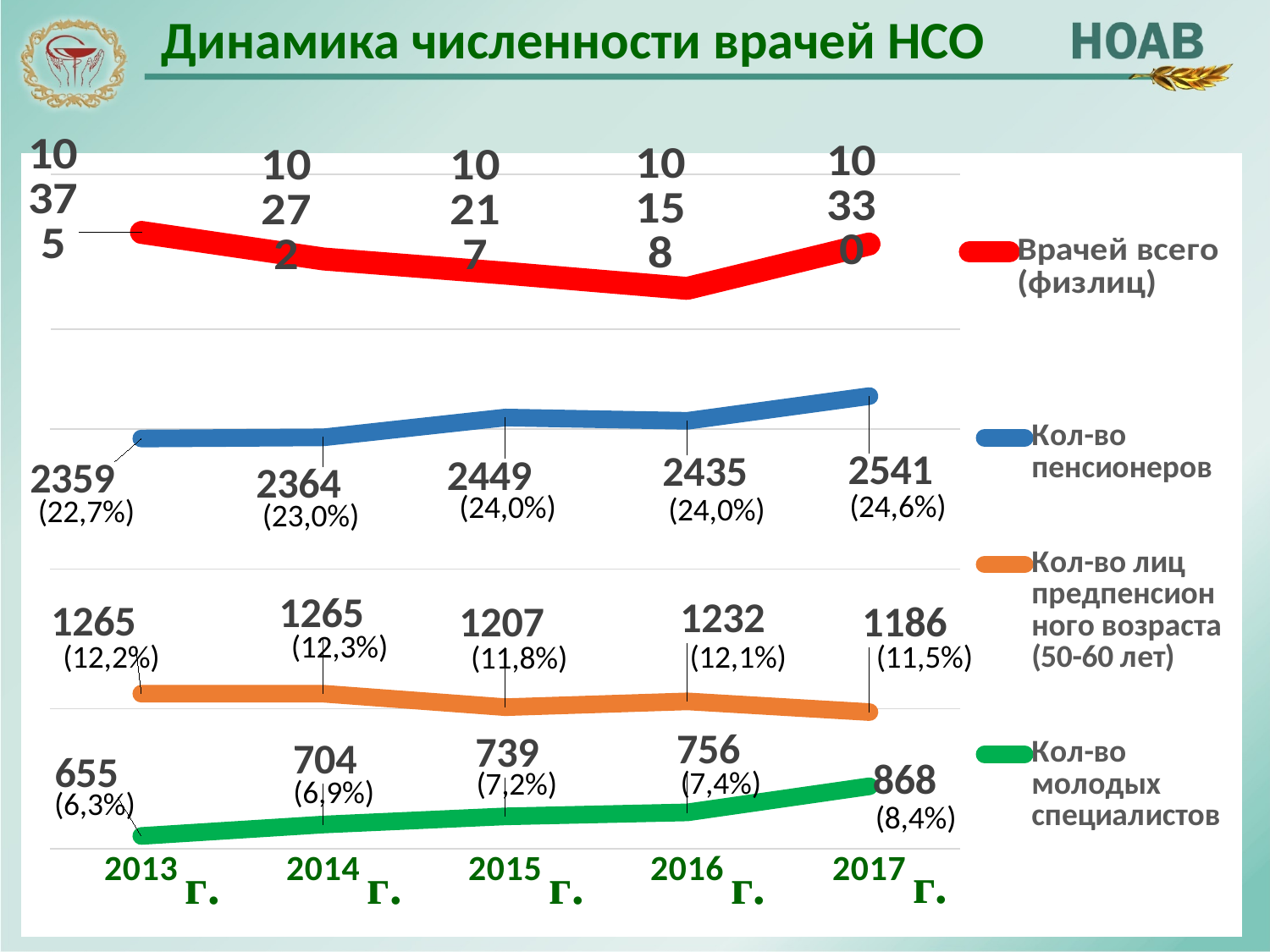
What is the value for Кол-во молодых специалистов in 2013? 655 How many years are shown on the x axis? 5 In which year is Кол-во лиц предпенсионного возраста lowest? 2017 How many series does the legend list? 4 What is the title of the chart? Динамика численности врачей НСО What is the difference between Кол-во пенсионеров in 2017 and in 2013? 182 What percentage is shown for Кол-во лиц предпенсионного возраста in 2015? 11,8% Which is larger: Кол-во молодых специалистов in 2016 or in 2014? 2016 What is the value for Кол-во пенсионеров in 2017? 2541 Does Кол-во молодых специалистов rise or fall from 2013 to 2017? rise What type of chart is shown on the slide? line chart In which year is Кол-во молодых специалистов highest? 2017